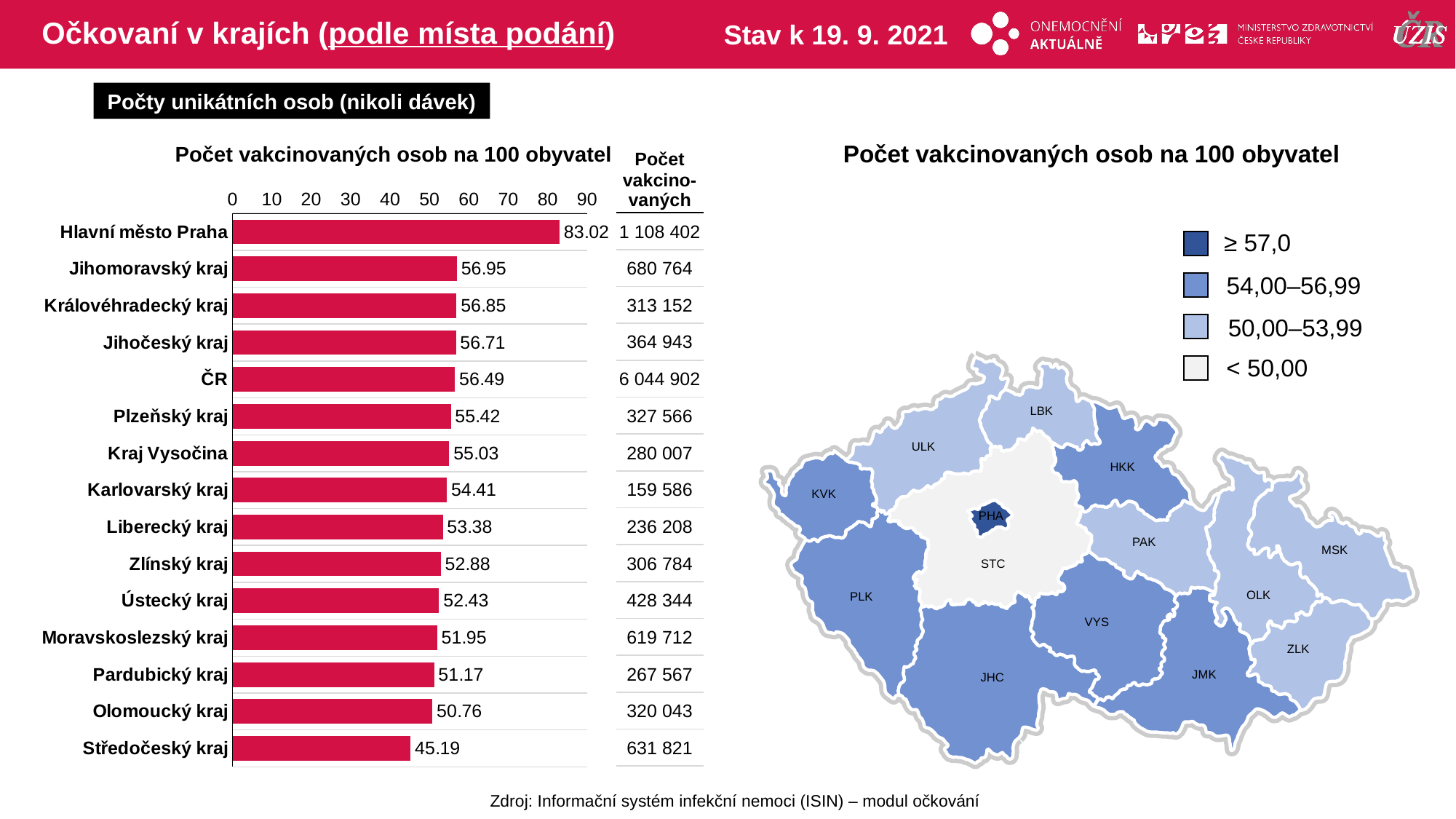
Which category has the lowest value in the bar chart? Středočeský kraj In the bar chart, what is the difference between the values for Jihomoravský kraj and Královéhradecký kraj? 0.10 How many categories (bars) are shown in the bar chart? 15 Which category has the highest value in the bar chart? Hlavní město Praha In the bar chart, is the value for Liberecký kraj greater or less than 50? greater What kind of chart is shown on the left of the slide? bar chart In the bar chart, which has the larger value: Plzeňský kraj or Kraj Vysočina? Plzeňský kraj In the bar chart, what is the difference between the values for Hlavní město Praha and Středočeský kraj? 37.83 In the bar chart, what is the value for ČR? 56.49 In the bar chart, what is the value for Hlavní město Praha? 83.02 What is the title of the bar chart on the left? Počet vakcinovaných osob na 100 obyvatel In the bar chart, what is the value for Olomoucký kraj? 50.76